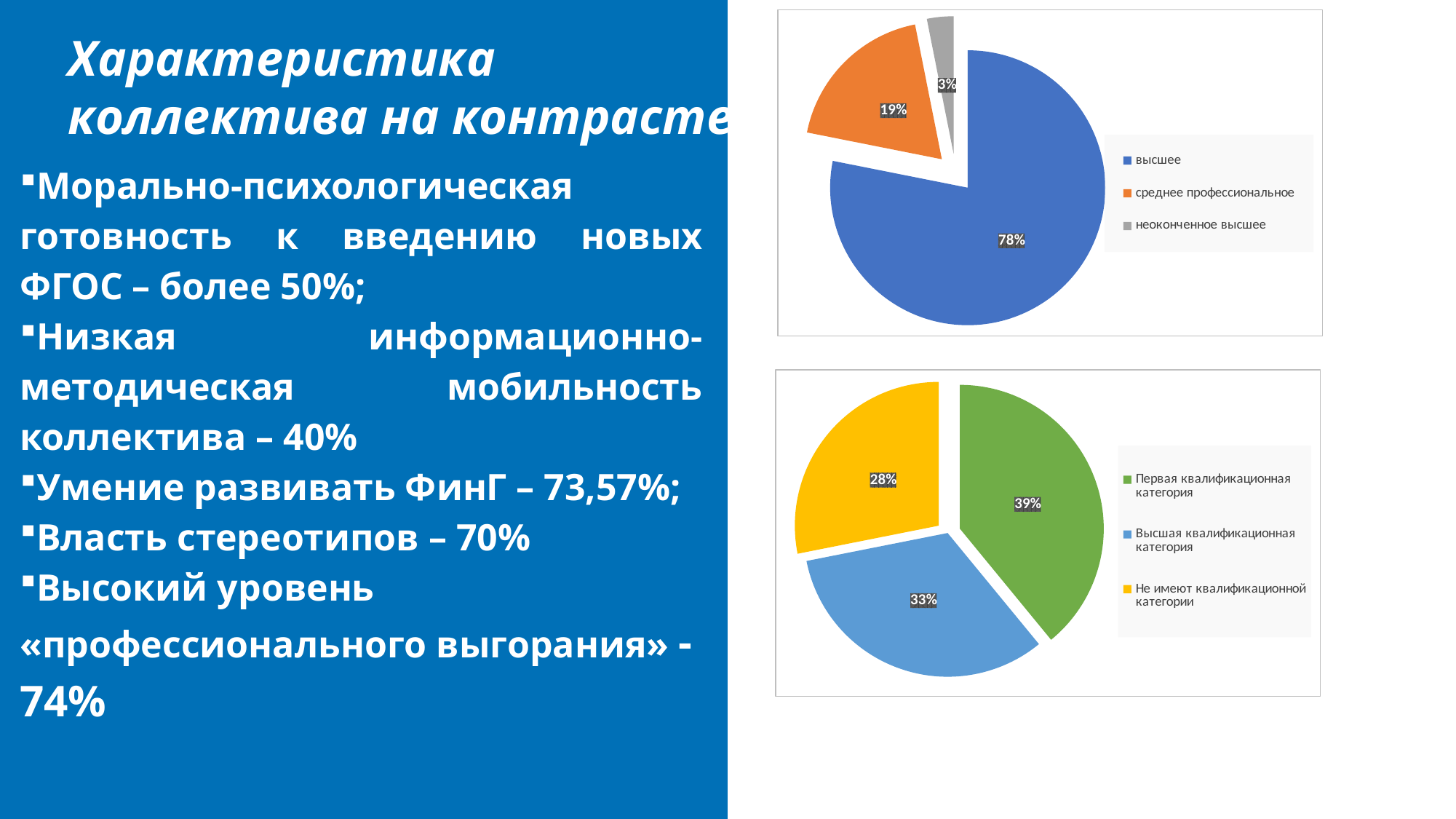
In the bottom pie chart, what share is labelled for "Не имеют квалификационной категории"? 28% What type of chart is the top chart on the slide? Pie chart In the top pie chart, what is the difference in percentage points between "высшее" and "среднее профессиональное"? 59 In the bottom pie chart, what share is labelled for "Первая квалификационная категория"? 39% In the top pie chart, which category has the smallest slice? неоконченное высшее In the top pie chart, which category has the largest slice? высшее In the top pie chart, what share is labelled for "высшее"? 78% In the bottom pie chart, what share is labelled for "Высшая квалификационная категория"? 33% How many slices does the bottom pie chart have? 3 In the top pie chart, what share is labelled for "среднее профессиональное"? 19% In the bottom pie chart, which category has the smallest slice? Не имеют квалификационной категории In the top pie chart, what share is labelled for "неоконченное высшее"? 3%